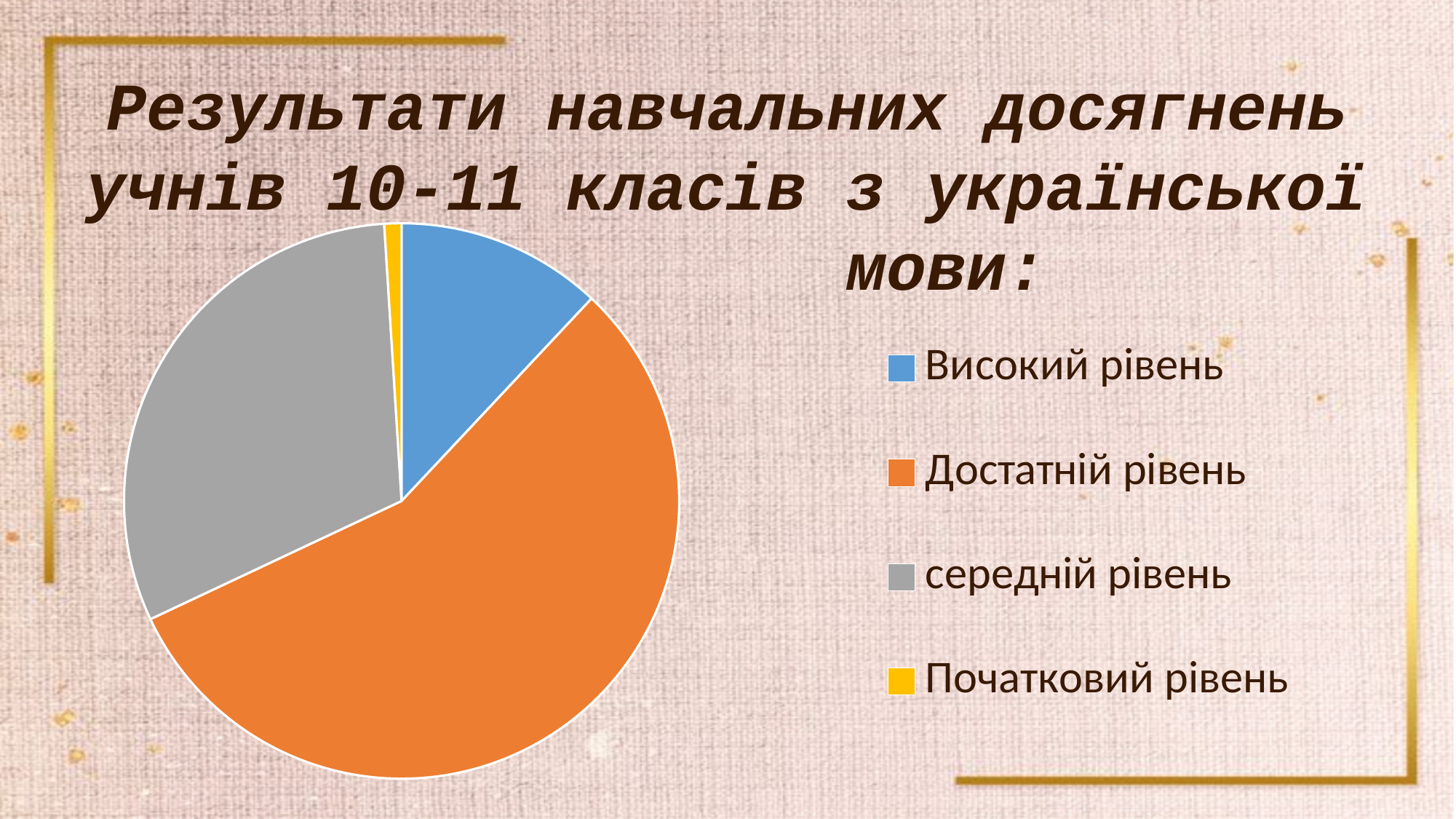
Which slice is larger: Достатній рівень or середній рівень? Достатній рівень Which category has the smallest slice of the pie chart? Початковий рівень Which slice is larger: Високий рівень or Початковий рівень? Високий рівень Which category has the largest slice of the pie chart? Достатній рівень Which category is the second-largest slice of the pie chart? середній рівень Which category is shown in yellow in the pie chart? Початковий рівень What colour represents Достатній рівень in the pie chart? orange What kind of chart is shown on the slide? pie chart How many categories does the pie chart show? 4